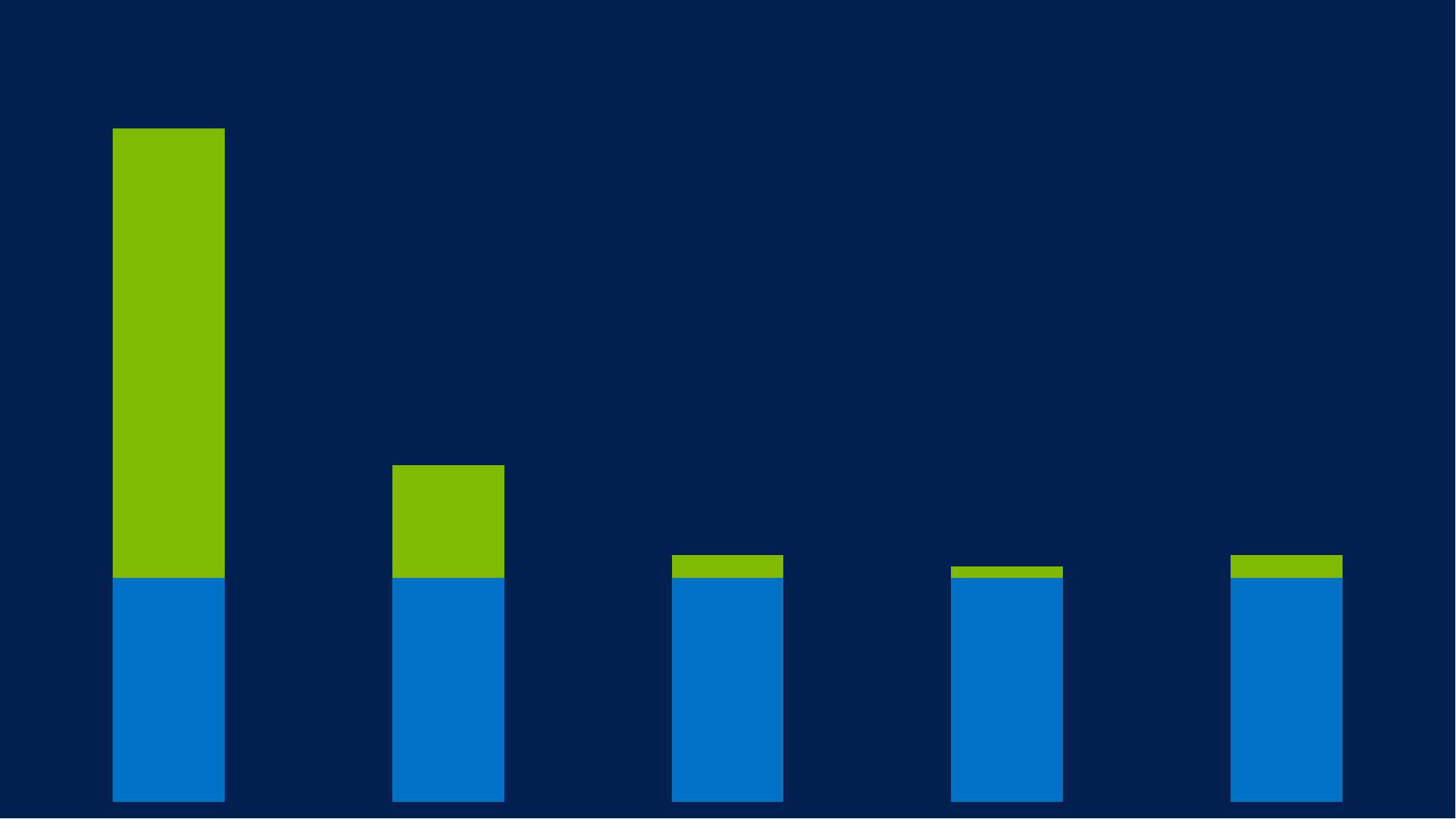
Is the leftmost bar taller or shorter than the second bar from the left? taller How many bars are plotted in the chart? 5 How many colours (segments) does each stacked bar contain? 2 Do the green segments of the bars generally rise or fall from left to right? fall What kind of chart is shown on the slide? bar chart Which colour segment sits at the bottom of each stacked bar? blue Which bar is the tallest in the chart, counting from the left? the first (leftmost) bar